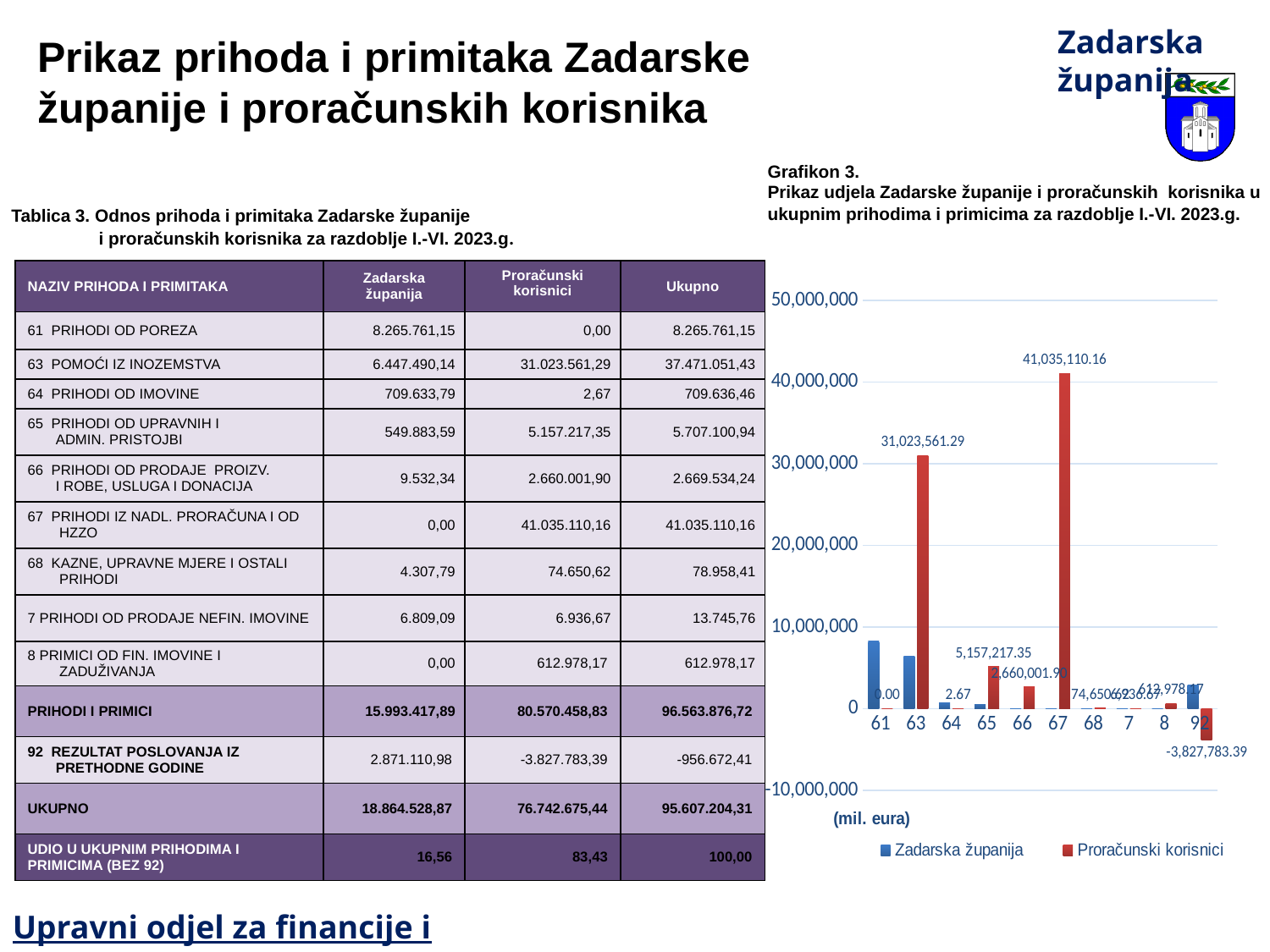
In Grafikon 3, is the value for Zadarska županija in category 61 greater or less than 10,000,000? less What kind of chart is Grafikon 3? bar chart In Grafikon 3, what is the value for Proračunski korisnici in category 65? 5,157,217.35 In Grafikon 3, what is the difference between the Proračunski korisnici values for categories 67 and 63? 10,011,548.87 In Grafikon 3, what is the value for Proračunski korisnici in category 63? 31,023,561.29 How many series does the legend of Grafikon 3 list? 2 How many categories are shown on the x axis of Grafikon 3? 10 In Grafikon 3, what is the value for Proračunski korisnici in category 67? 41,035,110.16 In Grafikon 3, which category has the highest value for Proračunski korisnici? 67 In Grafikon 3, for category 63, which series has the larger value: Zadarska županija or Proračunski korisnici? Proračunski korisnici In Grafikon 3, which category has the lowest value for Proračunski korisnici? 92 In Grafikon 3, what is the value for Proračunski korisnici in category 92? -3,827,783.39